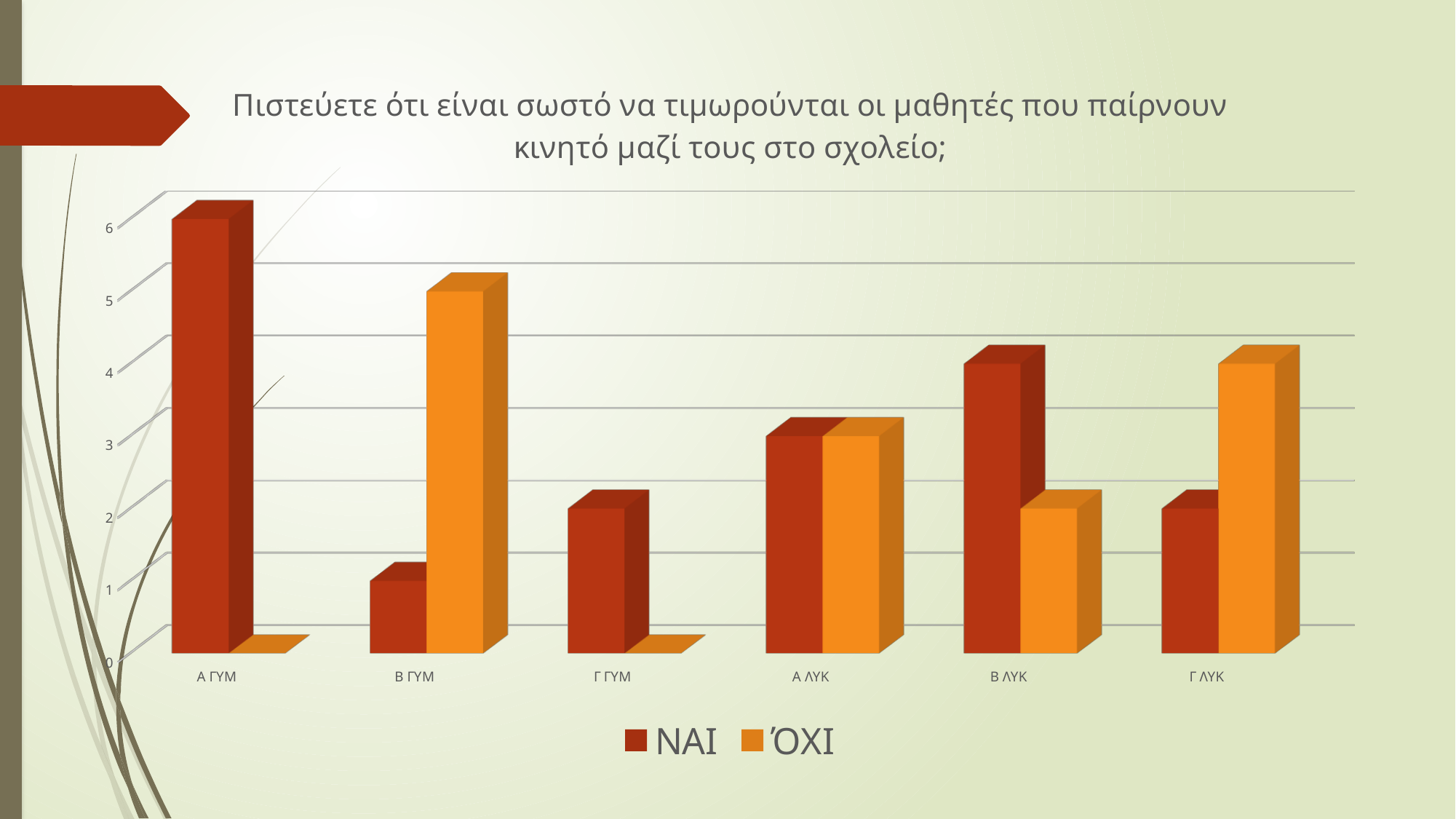
For Γ ΛΥΚ, which is larger, the ΝΑΙ value or the ΌΧΙ value? ΌΧΙ What is the ΝΑΙ value for Α ΓΥΜ? 6 What is the ΌΧΙ value for Β ΓΥΜ? 5 What kind of chart is shown on the slide? bar chart Which colour represents the ΌΧΙ series in the legend? orange How many series does the legend list? 2 Is the ΝΑΙ value for Β ΓΥΜ greater or less than 2? less Is the ΝΑΙ value for Β ΛΥΚ greater or less than 3? greater Which category has the highest ΝΑΙ value? Α ΓΥΜ How many categories are shown on the x axis? 6 For Β ΛΥΚ, which is larger, the ΝΑΙ value or the ΌΧΙ value? ΝΑΙ Which category has the highest ΌΧΙ value? Β ΓΥΜ